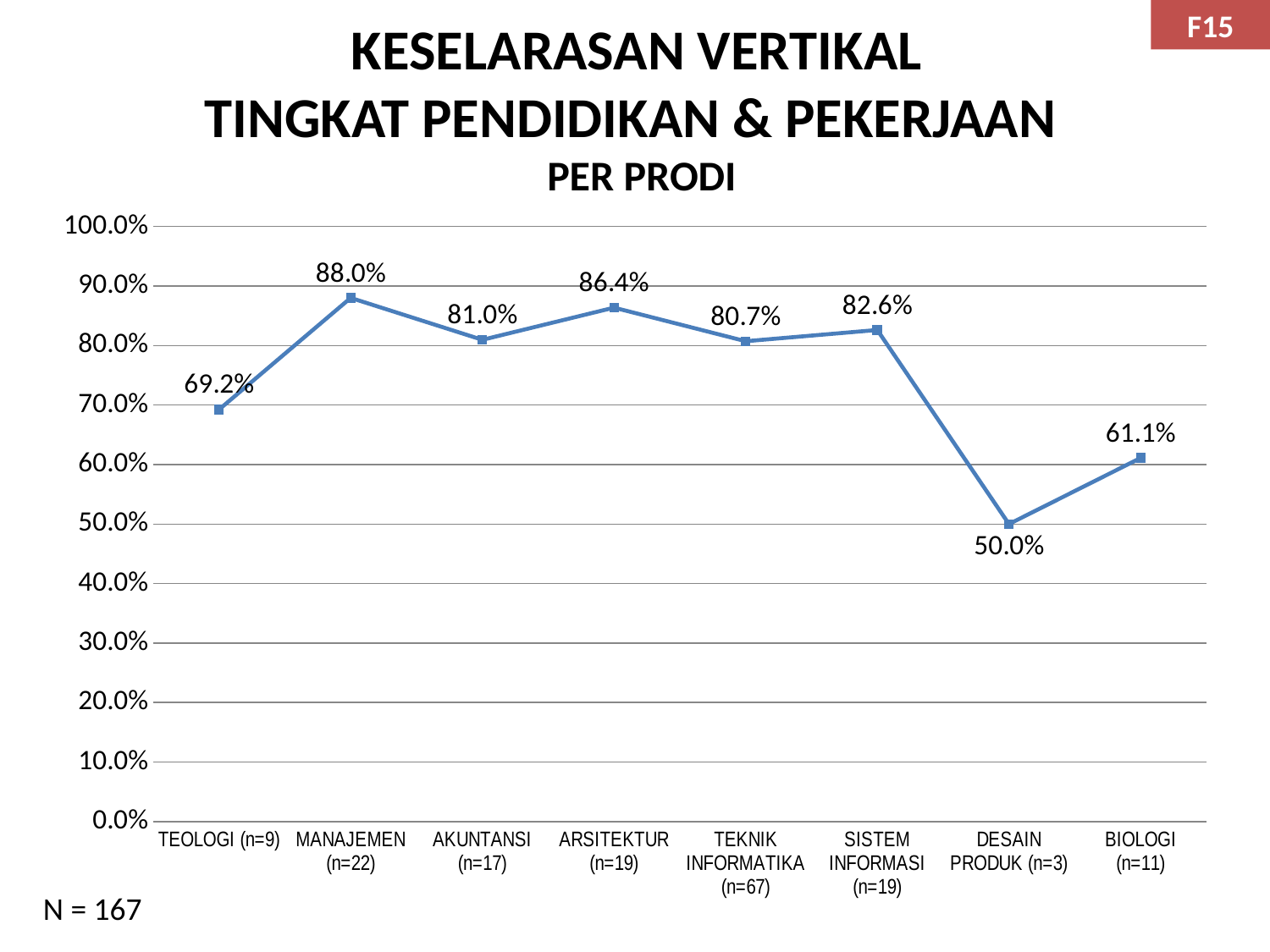
What is the value for DESAIN PRODUK (n=3)? 50.0% What is the value for MANAJEMEN (n=22)? 88.0% Is the value for TEOLOGI (n=9) greater or less than 60.0%? greater Which is larger, the value for SISTEM INFORMASI (n=19) or the value for BIOLOGI (n=11)? SISTEM INFORMASI (n=19) What is the difference between the values for MANAJEMEN (n=22) and DESAIN PRODUK (n=3)? 38.0% What is the value for TEKNIK INFORMATIKA (n=67)? 80.7% How many programs (prodi) are plotted on the chart? 8 Which program (prodi) has the highest value? MANAJEMEN (n=22) What is the difference between the values for ARSITEKTUR (n=19) and AKUNTANSI (n=17)? 5.4% What total N is stated below the chart? N = 167 Which program (prodi) has the lowest value? DESAIN PRODUK (n=3) What kind of chart is shown on the slide? line chart